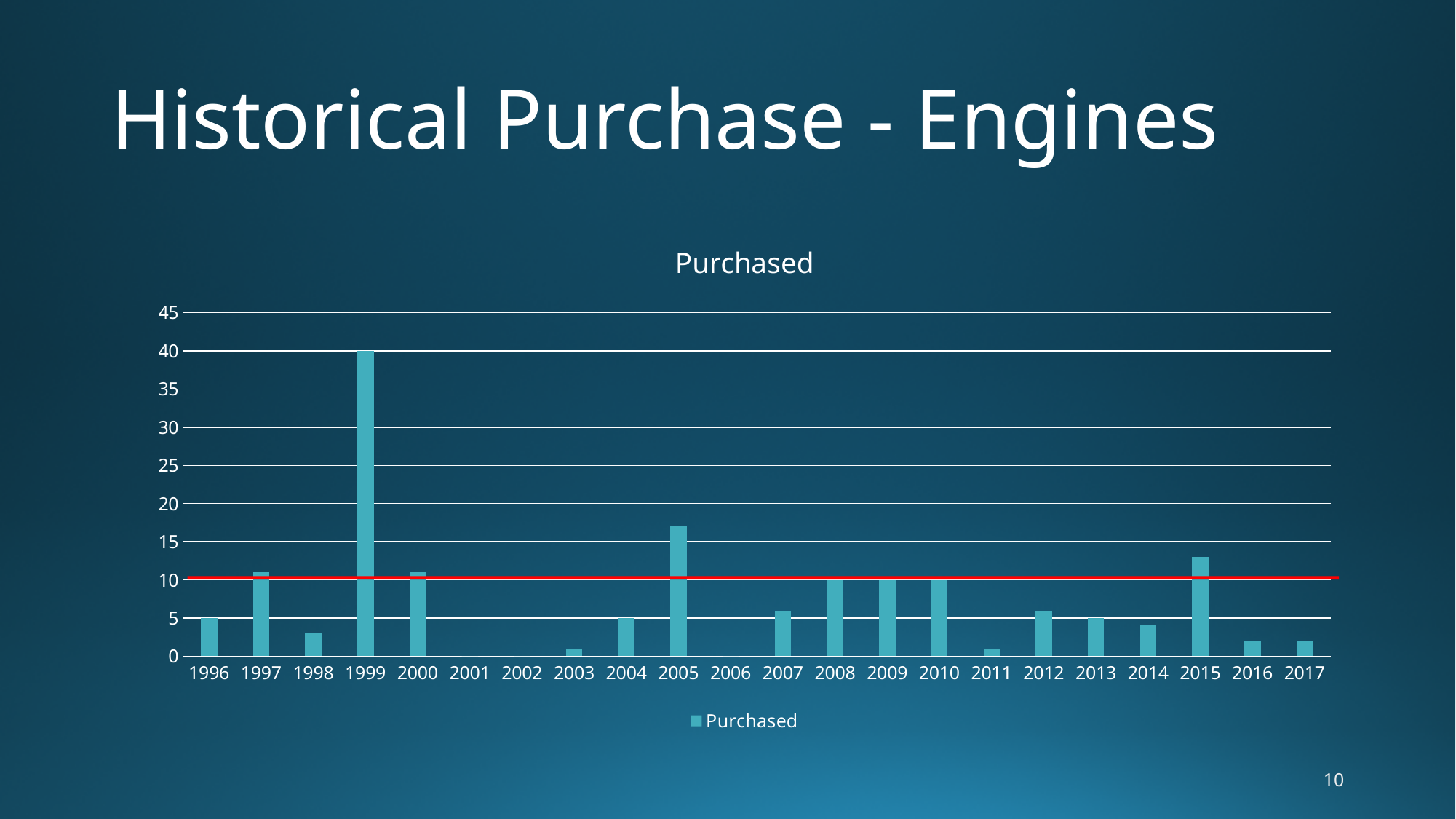
What kind of chart is shown on the slide? bar chart Which year has the highest number of engines purchased? 1999 How many series does the legend list? 1 Is the value for 2015 greater or less than 15? less What is the title of the chart? Purchased How many years are shown on the x axis of the chart? 22 Is the value for 2005 greater or less than 15? greater Is the value for 1998 greater or less than 5? less What is the value for 2008? 10 Which year has the larger value, 2005 or 2015? 2005 What is the value for 1999? 40